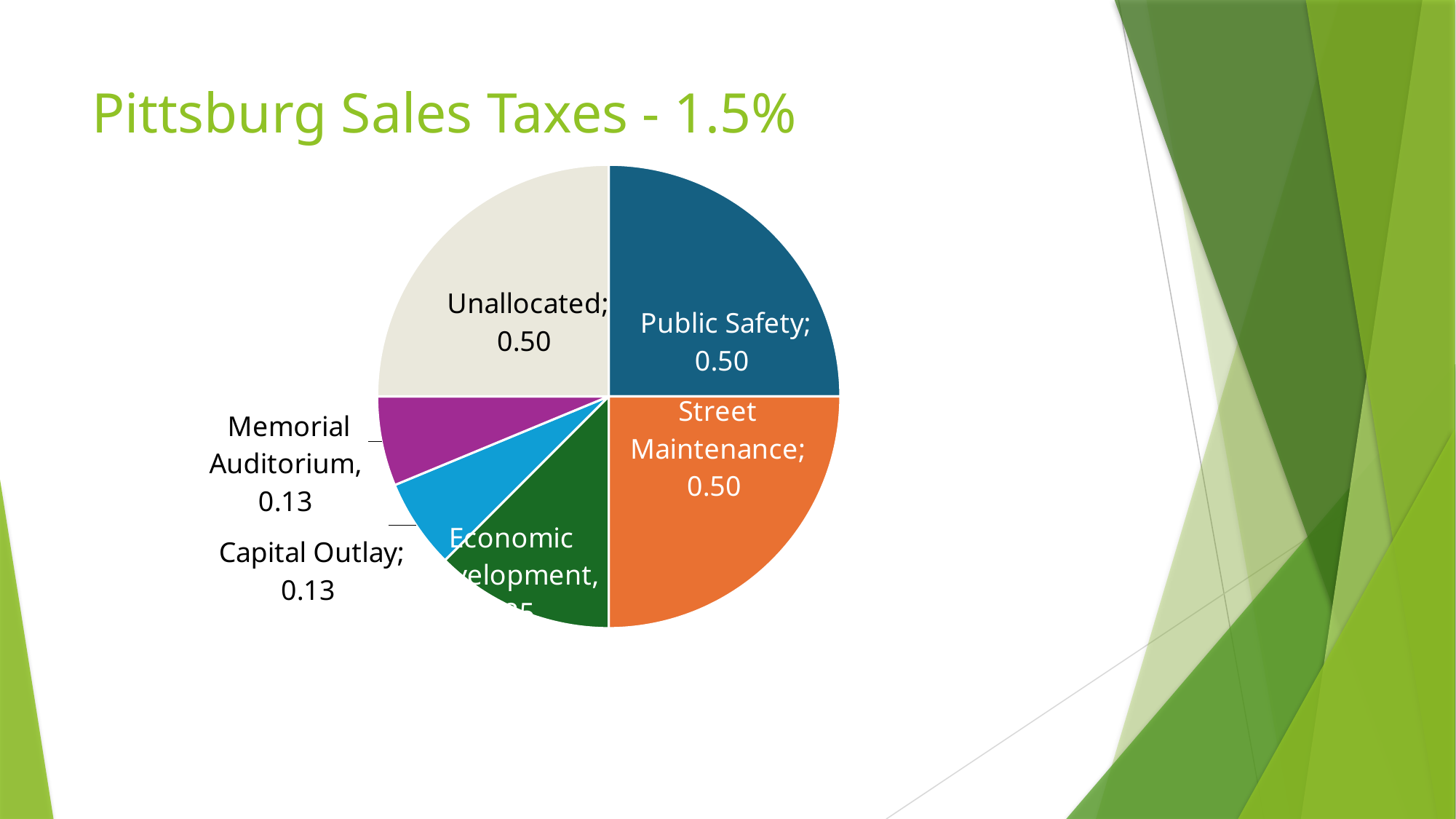
What is the value for Unallocated? 0.50 What colour is the Street Maintenance slice? orange What is the title of the slide? Pittsburg Sales Taxes - 1.5% How many slices does the pie chart have? 6 Which is larger, Public Safety or Capital Outlay? Public Safety What is the value for Public Safety? 0.50 What is the value for Capital Outlay? 0.13 Which is larger, Memorial Auditorium or Unallocated? Unallocated What type of chart is shown on the slide? pie chart What is the value for Street Maintenance? 0.50 What is the difference between the values for Public Safety and Capital Outlay? 0.37 What is the value for Memorial Auditorium? 0.13